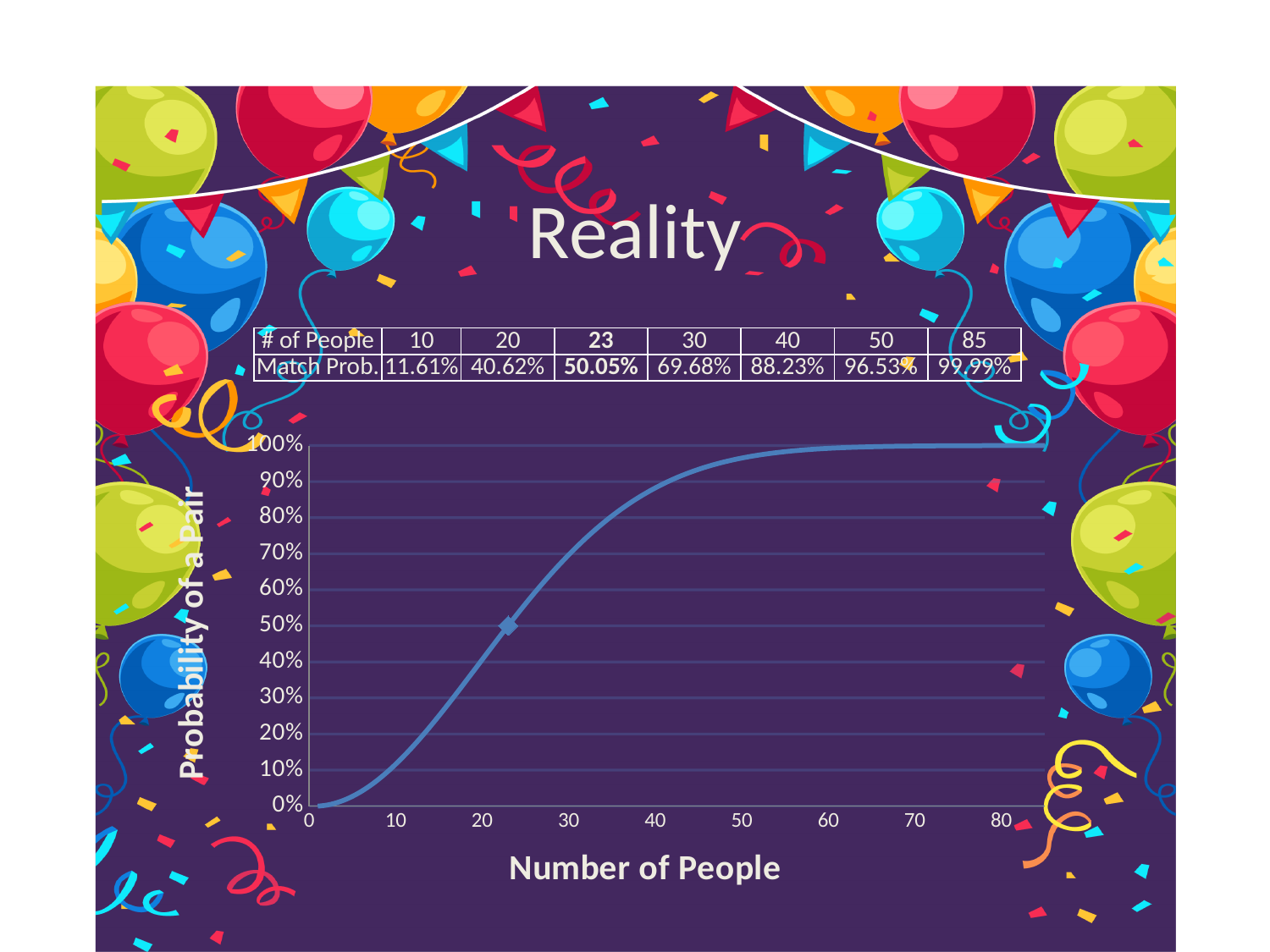
According to the table on the slide, what is the match probability for 50 people? 96.53% Is the probability of a pair for 10 people greater or less than 20%? less What kind of chart is shown on the slide? line chart Is the probability of a pair for 60 people greater or less than 90%? greater What is the title of the x axis of the chart? Number of People What is the title of the y axis of the chart? Probability of a Pair How many values of # of People are listed in the table on the slide? 7 Is the probability of a pair for 40 people greater or less than 80%? greater According to the table on the slide, how much higher is the match probability for 30 people than for 20 people? 29.06% According to the table on the slide, what is the match probability for 23 people? 50.05% Does the probability of a pair rise or fall as the number of people increases along the x axis? rise